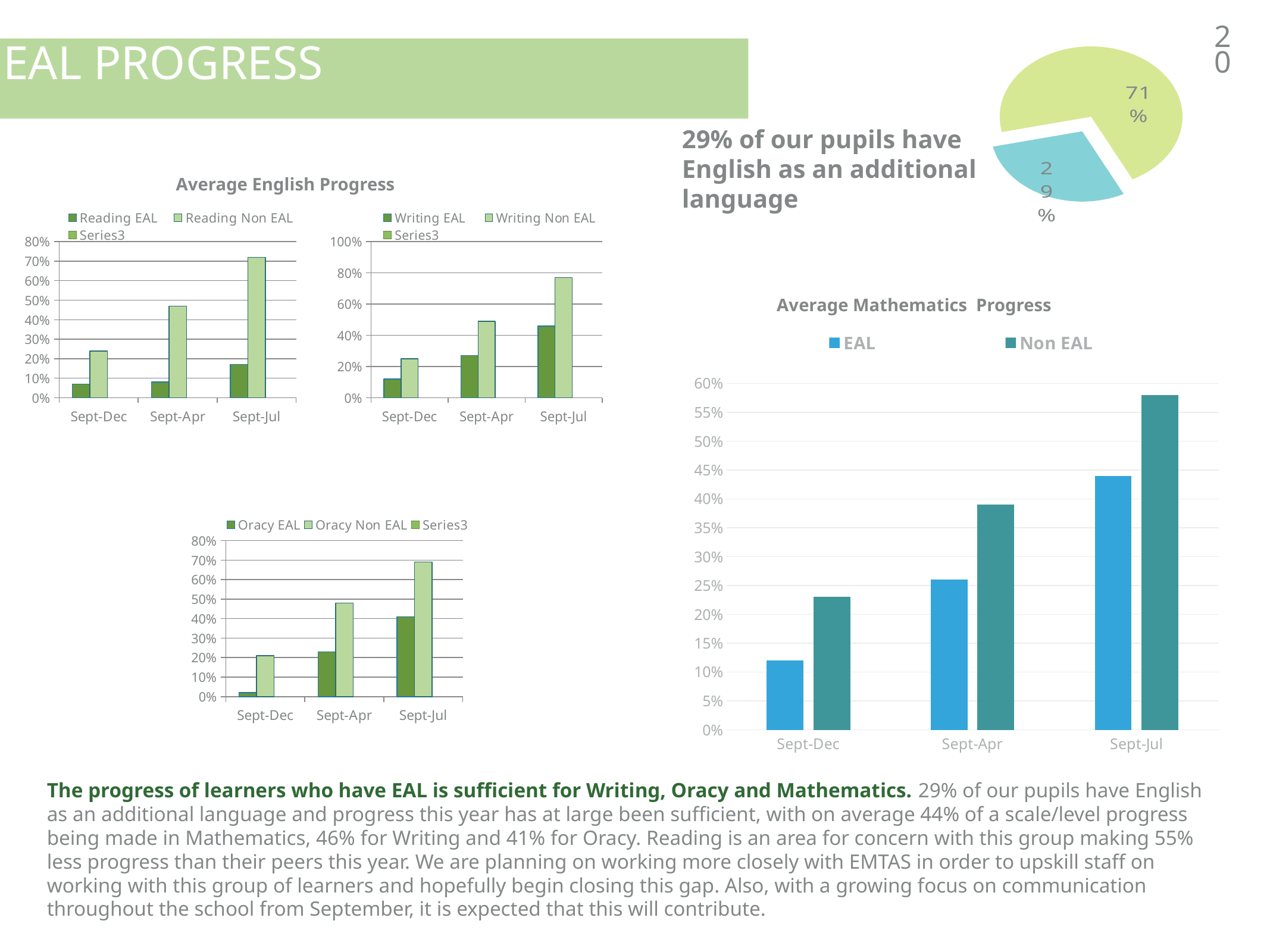
In the Average Mathematics Progress chart, which bar is the highest? Non EAL, Sept-Jul In the pie chart at the top right, what percentage is shown on the larger slice? 71% In the Average Mathematics Progress chart, is the EAL value for Sept-Dec greater or less than 15%? less In the Average Mathematics Progress chart, do the EAL values rise or fall from Sept-Dec to Sept-Jul? rise In the Reading chart (top left, under Average English Progress), is the Reading Non EAL value for Sept-Jul greater or less than 60%? greater In the Average Mathematics Progress chart, how many series does the legend list? 2 In the Average Mathematics Progress chart, is the Non EAL value for Sept-Jul greater or less than 55%? greater What kind of chart is the chart at the top right of the slide? pie chart In the pie chart at the top right, what share of the pie does the smaller slice represent? 29% In the Average Mathematics Progress chart, how many categories are shown on the x axis? 3 In the Writing chart (under Average English Progress), which is larger for Sept-Jul: Writing EAL or Writing Non EAL? Writing Non EAL